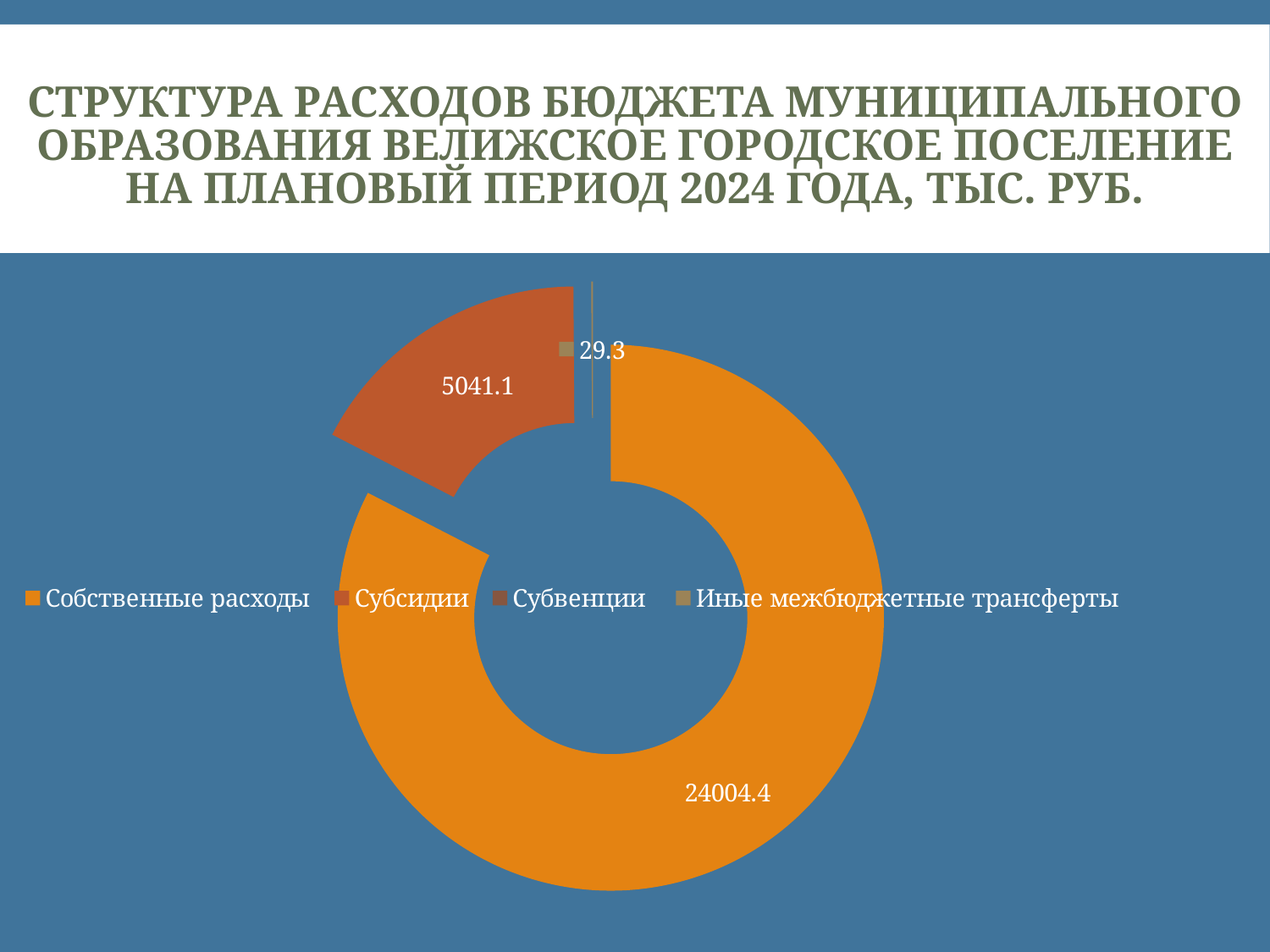
What is the value shown for Иные межбюджетные трансферты? 29.3 Which legend entry is listed first? Собственные расходы What is the difference between the slice labelled 5041.1 and the value for Иные межбюджетные трансферты? 5011.8 Which category has the largest slice of the chart? Собственные расходы Which category has the smallest labelled value on the chart? Иные межбюджетные трансферты How many data labels are printed on the chart? 3 Which is larger: the value for Собственные расходы or the slice labelled 5041.1? Собственные расходы In what units are the values on the slide expressed, according to the title? тыс. руб. How many entries does the legend list? 4 What is the difference between the value for Собственные расходы and the slice labelled 5041.1? 18963.3 What is the value shown for Собственные расходы? 24004.4 What kind of chart is shown on the slide? doughnut (pie) chart